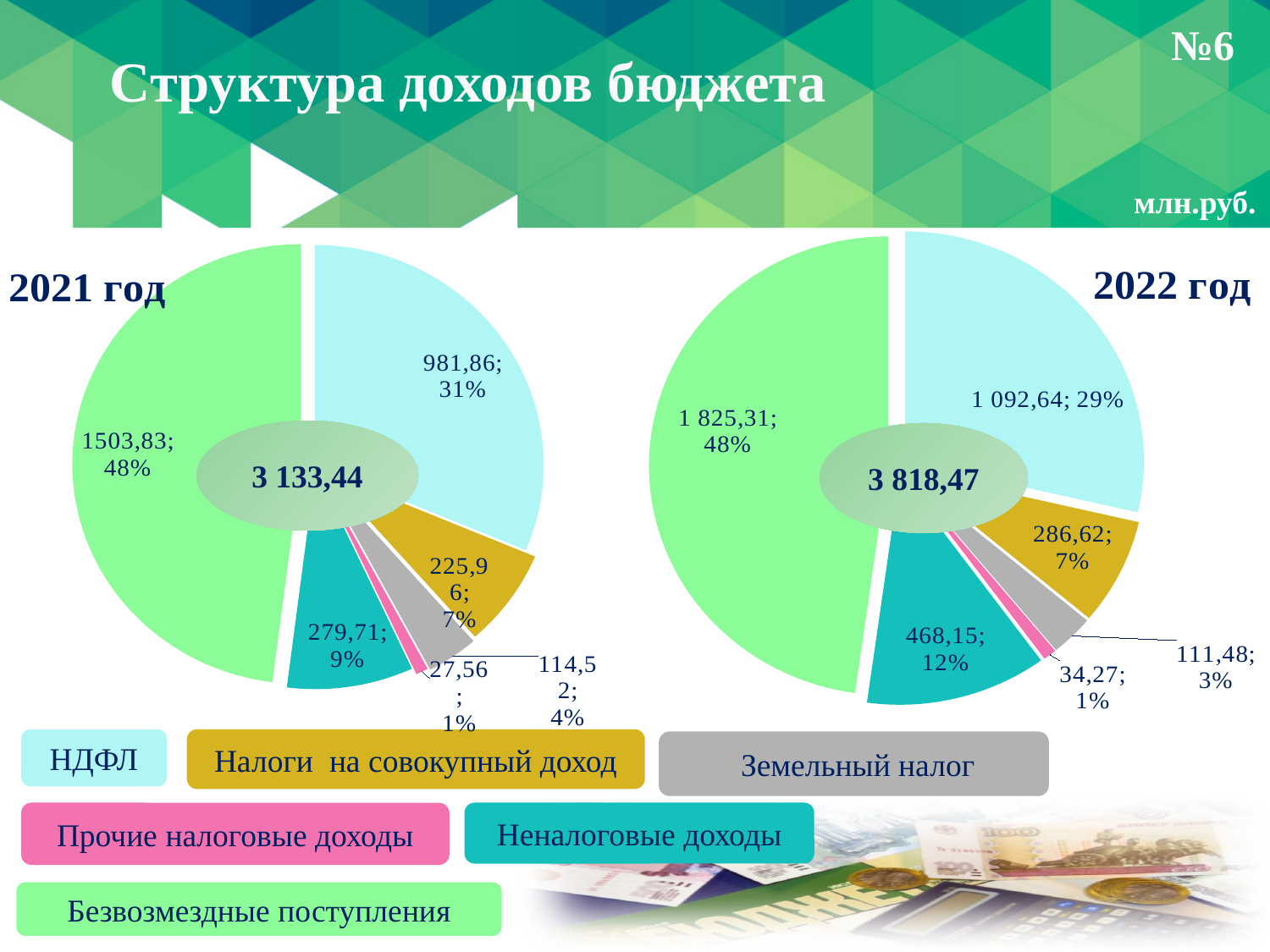
Which is larger: Налоги на совокупный доход in the 2021 год chart or in the 2022 год chart? 2022 год What total is shown in the centre of the 2022 год chart? 3 818,47 In the 2022 год chart, what share of the pie is Неналоговые доходы? 12% What kind of charts are shown on the slide? Pie charts In the 2021 год chart, what is the value for НДФЛ? 981,86 In the 2021 год chart, what share of the pie is Земельный налог? 4% What is the title of the slide? Структура доходов бюджета In the 2021 год chart, which category has the largest slice? Безвозмездные поступления In the 2022 год chart, which category has the smallest slice? Прочие налоговые доходы What is the difference between the Неналоговые доходы value in the 2022 год chart and in the 2021 год chart? 188,44 How many categories does each pie chart contain? 6 In the 2022 год chart, what is the value for Безвозмездные поступления? 1 825,31